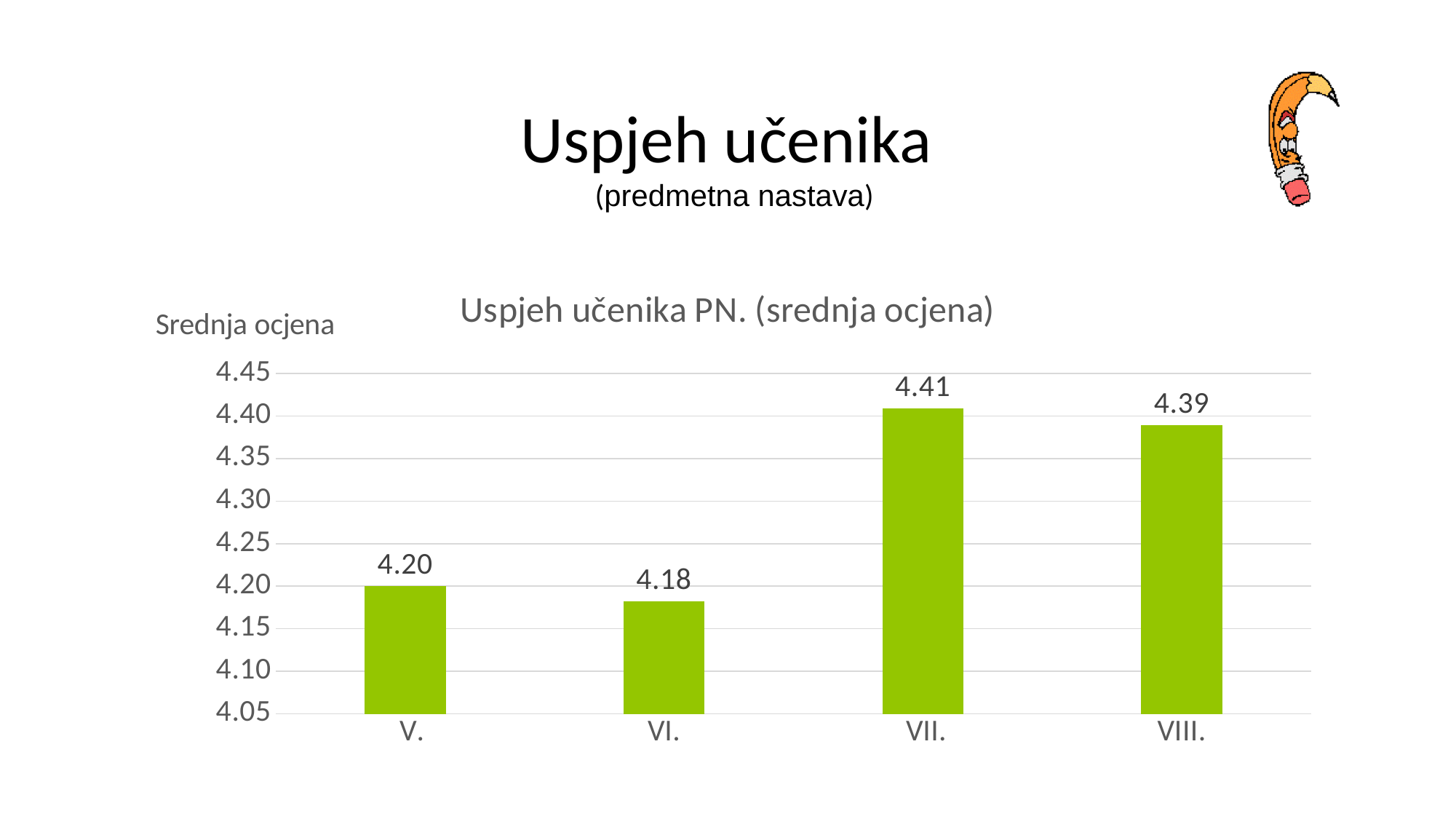
How many classes are shown on the chart? 4 Which class has a higher average grade, VI. or VIII.? VIII. Which class has the lowest average grade? VI. What is the title of the chart? Uspjeh učenika PN. (srednja ocjena) What is the average grade (srednja ocjena) for class V.? 4.20 What is the average grade for class VI.? 4.18 What kind of chart is shown on the slide? bar chart Which class has the highest average grade? VII. Is the value for class VIII. greater or less than 4.30? greater What is the difference between the average grades of class VII. and class V.? 0.21 What is the average grade for class VIII.? 4.39 What is the average grade for class VII.? 4.41